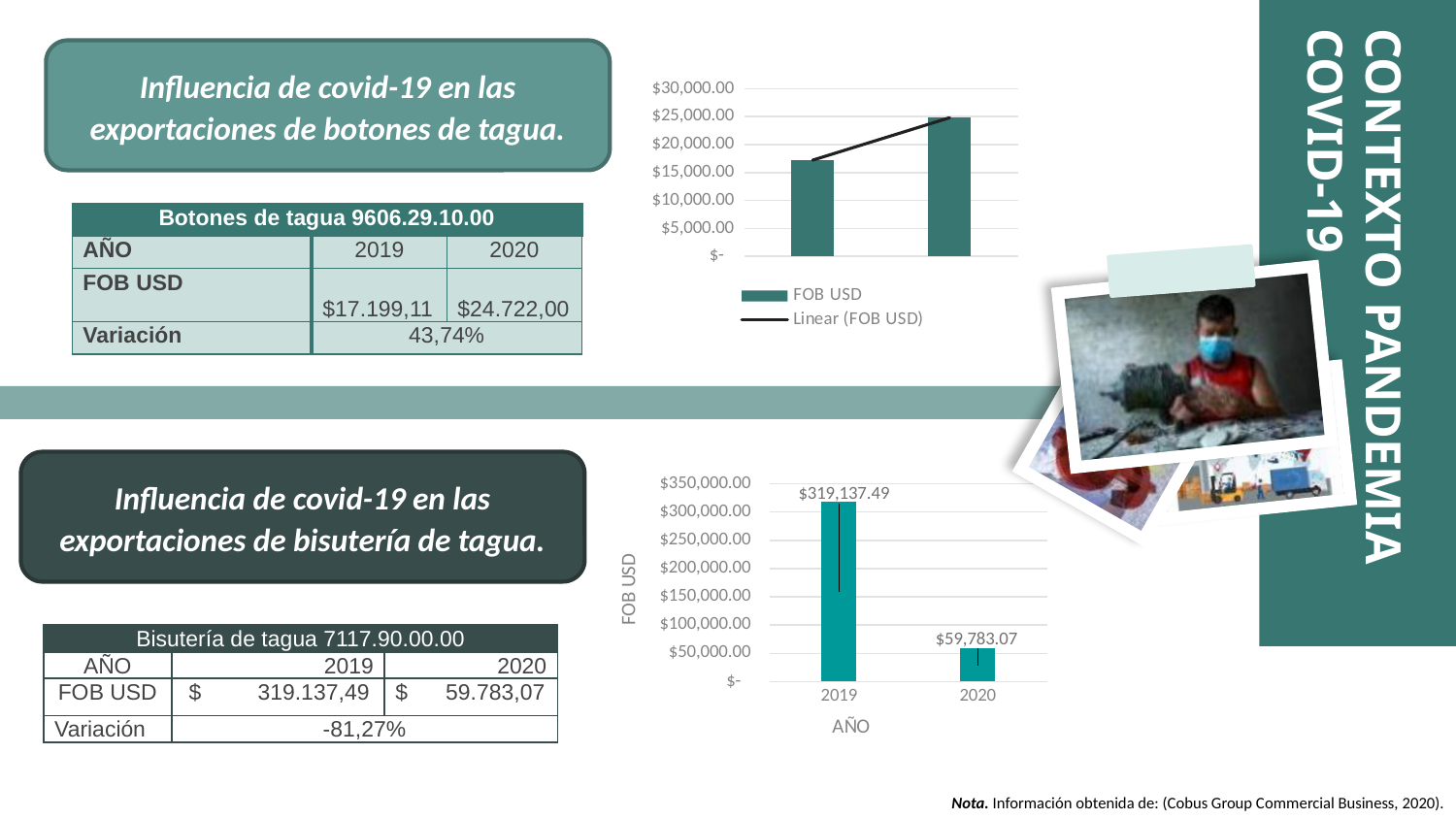
In the bottom chart, what is the value for 2019? $319,137.49 How many entries does the legend of the top chart list? 2 In the bottom chart, which year has the higher value? 2019 In the bottom chart, what is the title of the vertical axis? FOB USD In the bottom chart, how many years are plotted? 2 What kind of chart is the top chart? bar chart In the bottom chart, what is the value for 2020? $59,783.07 In the bottom chart, which year has the lowest value? 2020 In the bottom chart, do the values rise or fall from 2019 to 2020? fall In the top chart, is the value of the left bar greater or less than $20,000.00? less In the top chart, is the value of the right bar greater or less than $20,000.00? greater In the bottom chart, what is the difference between the 2019 and 2020 values? $259,354.42